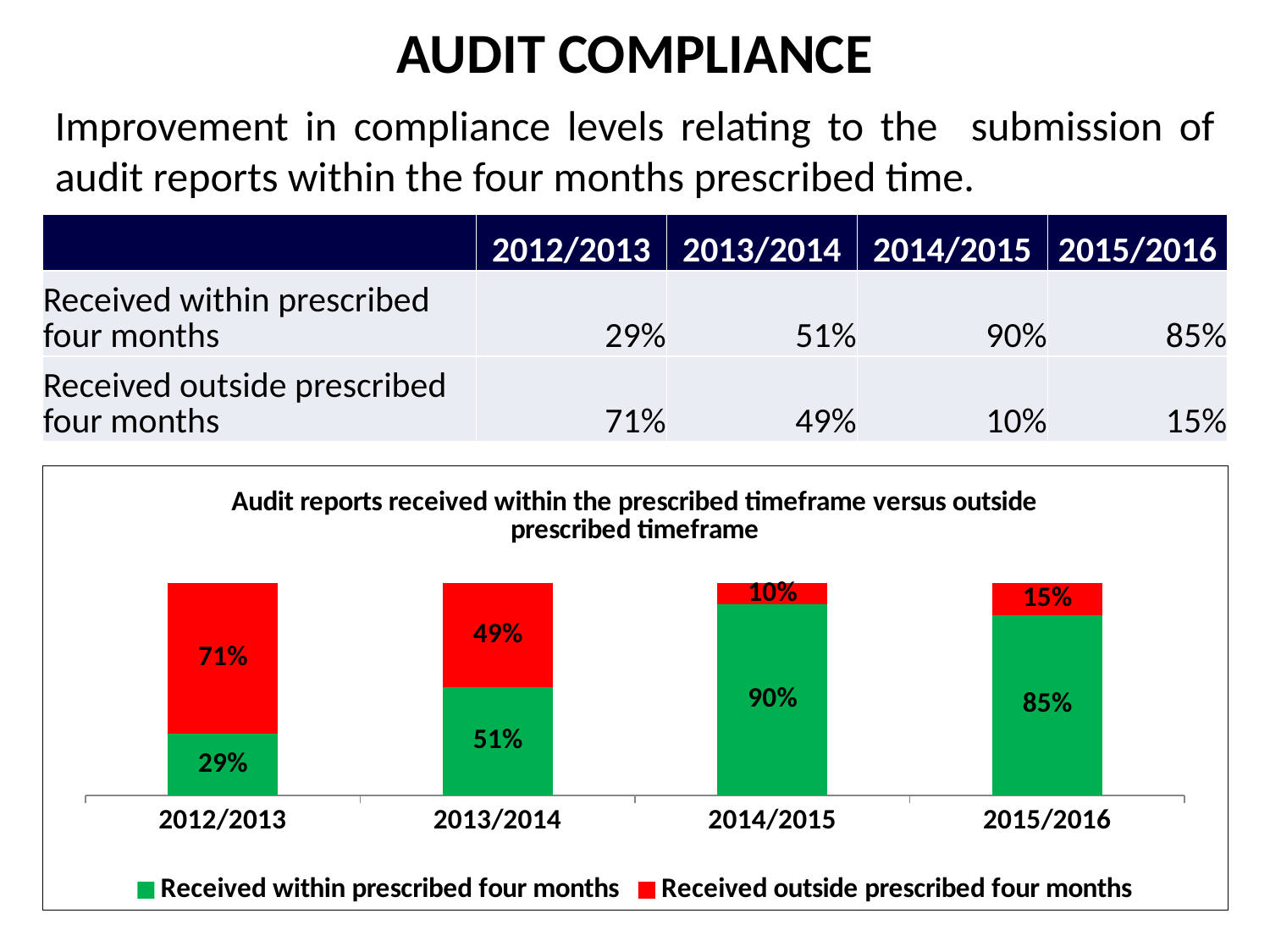
What is the value for 'Received within prescribed four months' in 2014/2015? 90% What is the difference between 'Received outside prescribed four months' and 'Received within prescribed four months' in 2012/2013? 42% What kind of chart is shown on the slide? Stacked bar chart What is the value for 'Received outside prescribed four months' in 2012/2013? 71% What is the value for 'Received within prescribed four months' in 2015/2016? 85% How many series does the chart legend list? 2 In 2013/2014, which is larger: 'Received within prescribed four months' or 'Received outside prescribed four months'? Received within prescribed four months What is the total of the stacked bar for 2015/2016? 100% Which year has the lowest value for 'Received outside prescribed four months'? 2014/2015 Which year has the highest value for 'Received within prescribed four months'? 2014/2015 How many years are shown on the x axis of the chart? 4 What colour represents 'Received outside prescribed four months' in the chart? Red